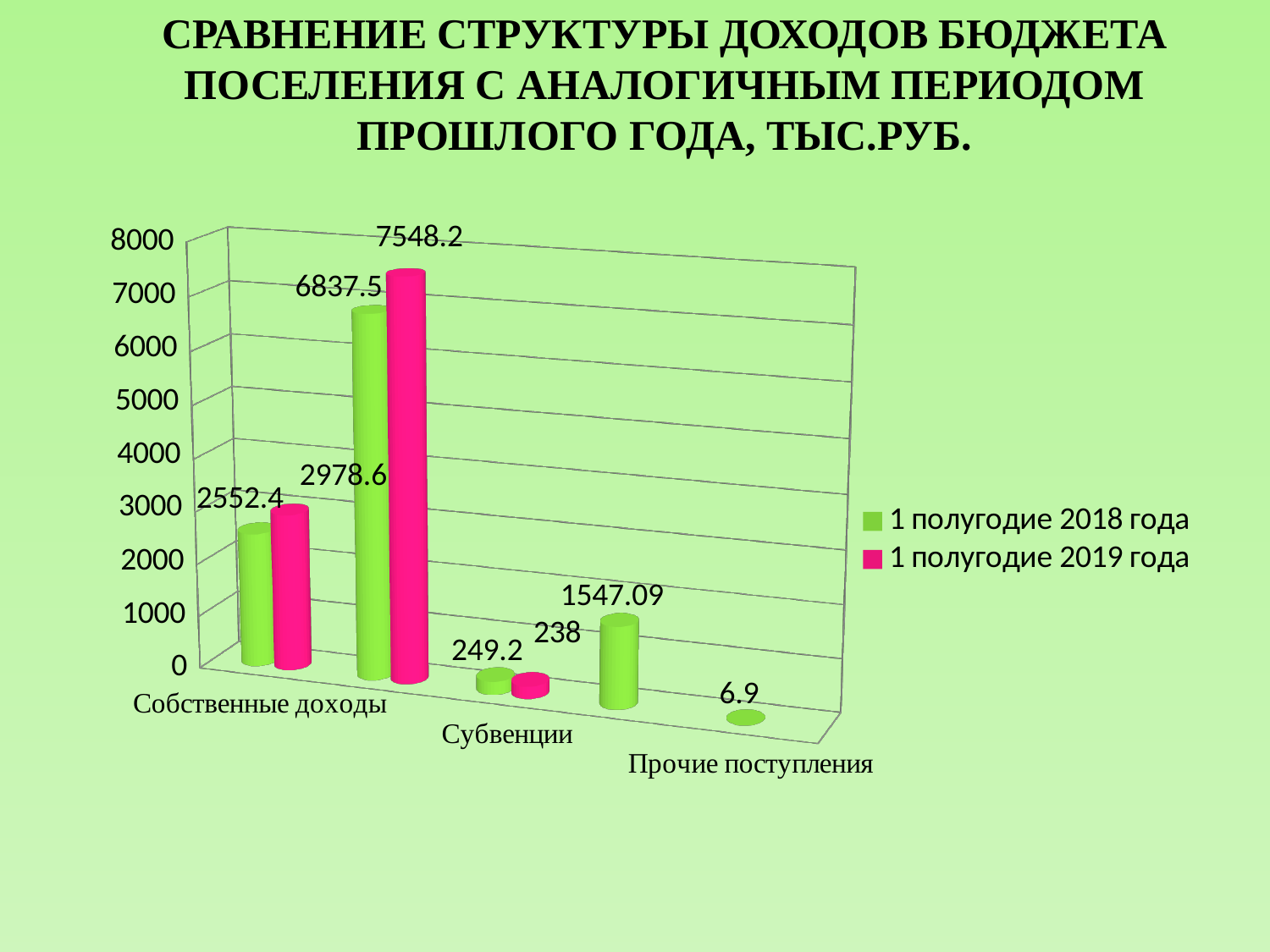
For Субвенции, which period has the larger value: 1 полугодие 2018 года or 1 полугодие 2019 года? 1 полугодие 2018 года What is the highest value shown for 1 полугодие 2019 года? 7548.2 What kind of chart is shown on the slide? Bar chart What is the value for Субвенции in 1 полугодие 2019 года? 238 What is the value for Собственные доходы in 1 полугодие 2019 года? 2978.6 What is the value for Прочие поступления in 1 полугодие 2018 года? 6.9 What is the value for Собственные доходы in 1 полугодие 2018 года? 2552.4 How many series does the legend list? 2 By how much did Собственные доходы increase from 1 полугодие 2018 года to 1 полугодие 2019 года? 426.2 What is the difference between the Субвенции values for 1 полугодие 2018 года and 1 полугодие 2019 года? 11.2 Which category has the lowest value for 1 полугодие 2018 года? Прочие поступления